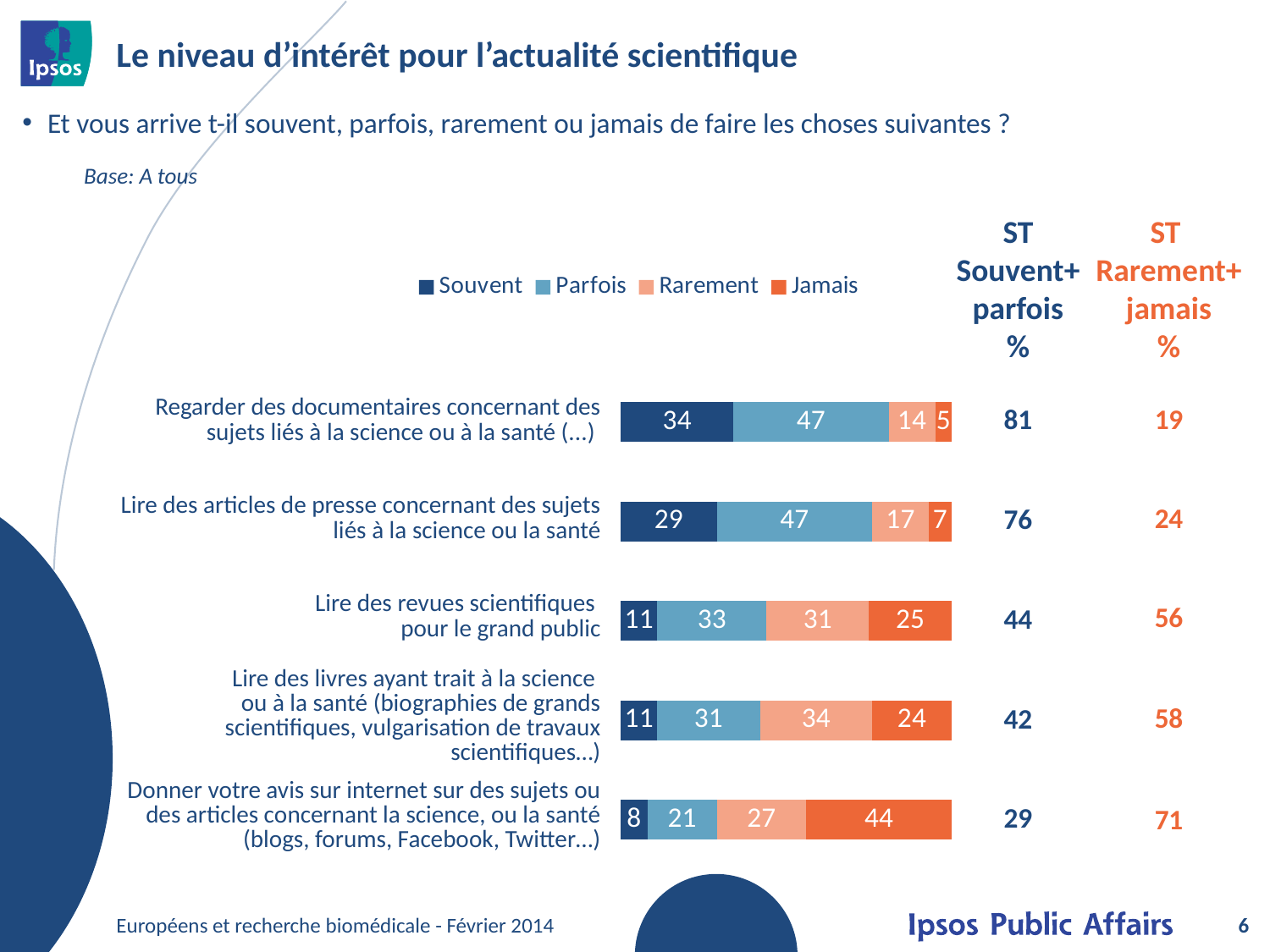
What kind of chart is shown on the slide? Stacked bar chart What is the 'Rarement' value for 'Lire des livres ayant trait à la science ou à la santé'? 34 Which is larger: the 'Parfois' value for 'Lire des revues scientifiques pour le grand public' or the 'Parfois' value for 'Lire des livres ayant trait à la science ou à la santé'? Lire des revues scientifiques pour le grand public How many series does the legend list? 4 Which category has the lowest 'Souvent' value? Donner votre avis sur internet sur des sujets ou des articles concernant la science, ou la santé What is the 'ST Souvent+parfois' percentage for 'Lire des articles de presse concernant des sujets liés à la science ou la santé'? 76 Which series is shown in the darkest blue colour in the legend? Souvent What is the 'Jamais' value for 'Donner votre avis sur internet sur des sujets ou des articles concernant la science, ou la santé'? 44 How many categories (activities) are plotted in the chart? 5 What is the 'Souvent' value for 'Regarder des documentaires concernant des sujets liés à la science ou à la santé'? 34 Which category has the highest 'Souvent' value? Regarder des documentaires concernant des sujets liés à la science ou à la santé What is the difference between the 'Jamais' values for 'Lire des revues scientifiques pour le grand public' and 'Lire des articles de presse concernant des sujets liés à la science ou la santé'? 18